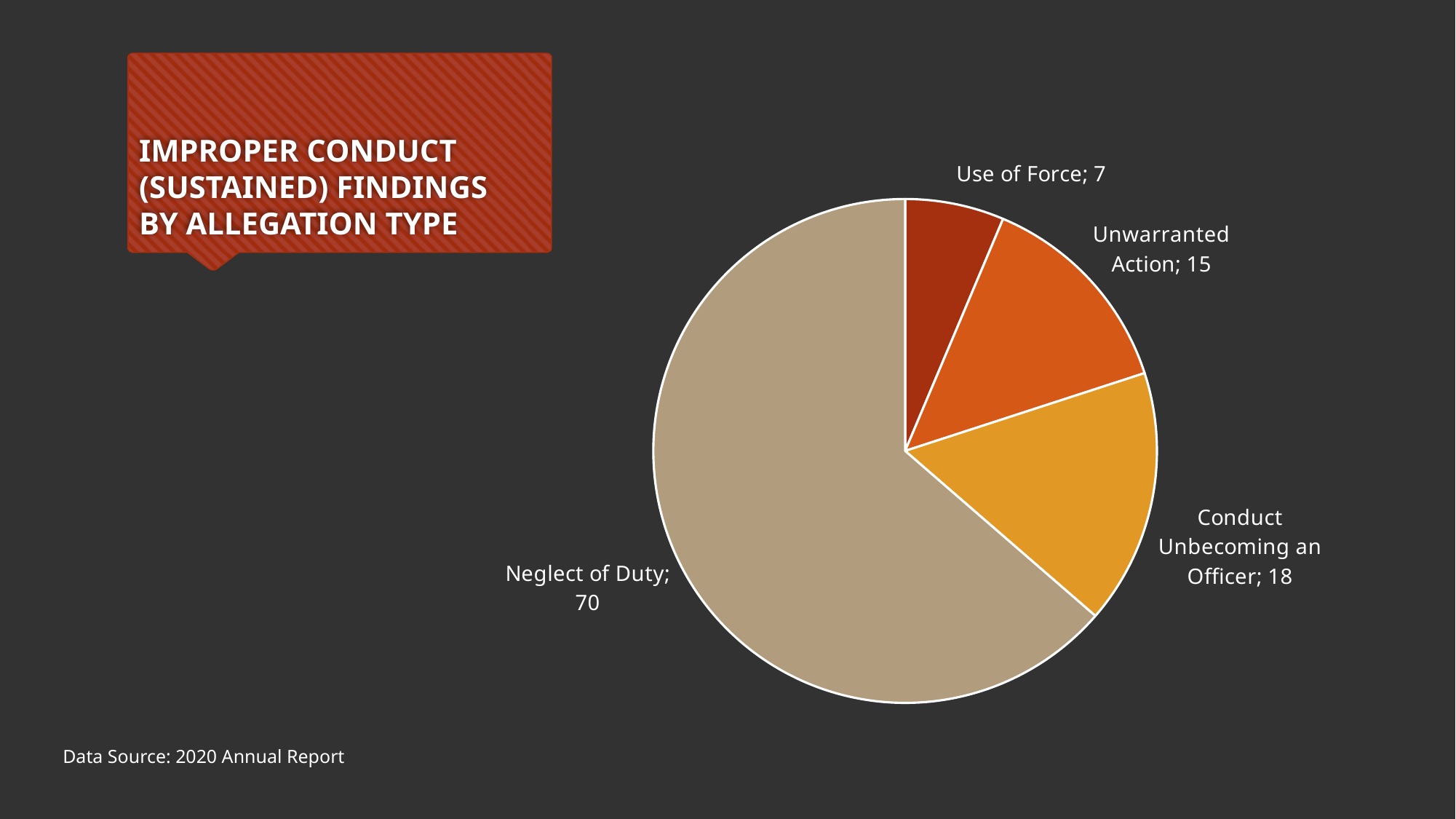
What type of chart is shown on the slide? Pie chart Which is larger, the value for Unwarranted Action or the value for Conduct Unbecoming an Officer? Conduct Unbecoming an Officer Which allegation type has the lowest number of sustained findings? Use of Force Which allegation type has the highest number of sustained findings? Neglect of Duty What is the value for Conduct Unbecoming an Officer? 18 What is the value for Use of Force? 7 What is the title of the chart on the slide? Improper Conduct (Sustained) Findings by Allegation Type What is the total of all the slices in the pie chart? 110 What is the value for Neglect of Duty? 70 How many allegation types are shown in the pie chart? 4 What is the difference between the values for Neglect of Duty and Conduct Unbecoming an Officer? 52 What is the value for Unwarranted Action? 15